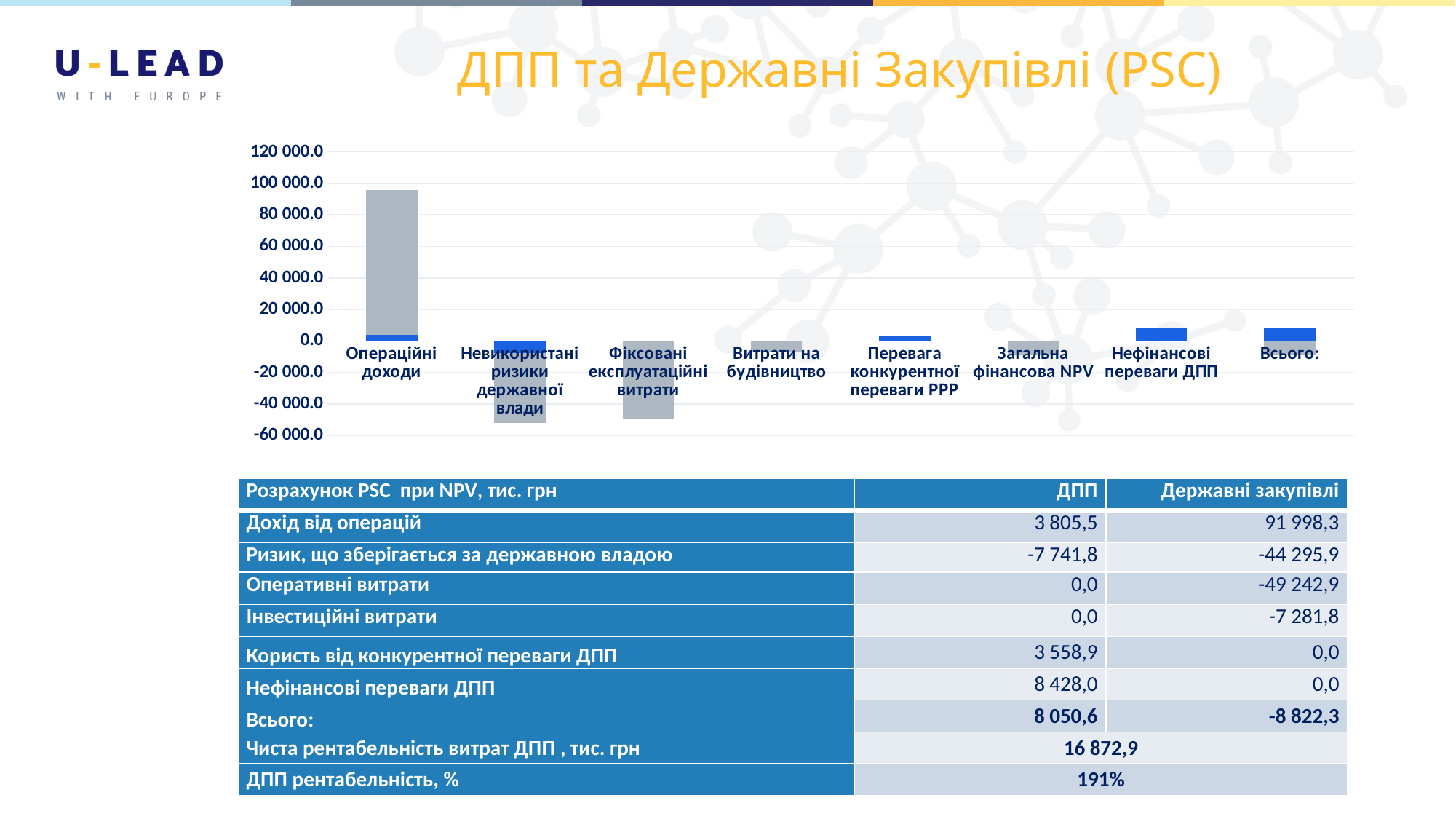
How many categories are shown along the x axis of the chart? 8 Is the grey bar value for Невикористані ризики державної влади greater or less than -20 000.0? less Which is larger: the blue bar for Нефінансові переваги ДПП or the blue bar for Перевага конкурентної переваги PPP? Нефінансові переваги ДПП What is the highest value shown on the chart's vertical axis? 120 000.0 Is the grey bar value for Витрати на будівництво greater or less than -20 000.0? greater Which category has the tallest bar in the chart? Операційні доходи Is the grey bar value for Операційні доходи greater or less than 80 000.0? greater What kind of chart is shown on the slide? bar chart What is the lowest value shown on the chart's vertical axis? -60 000.0 Which is larger: the grey bar for Операційні доходи or the grey bar for Витрати на будівництво? Операційні доходи